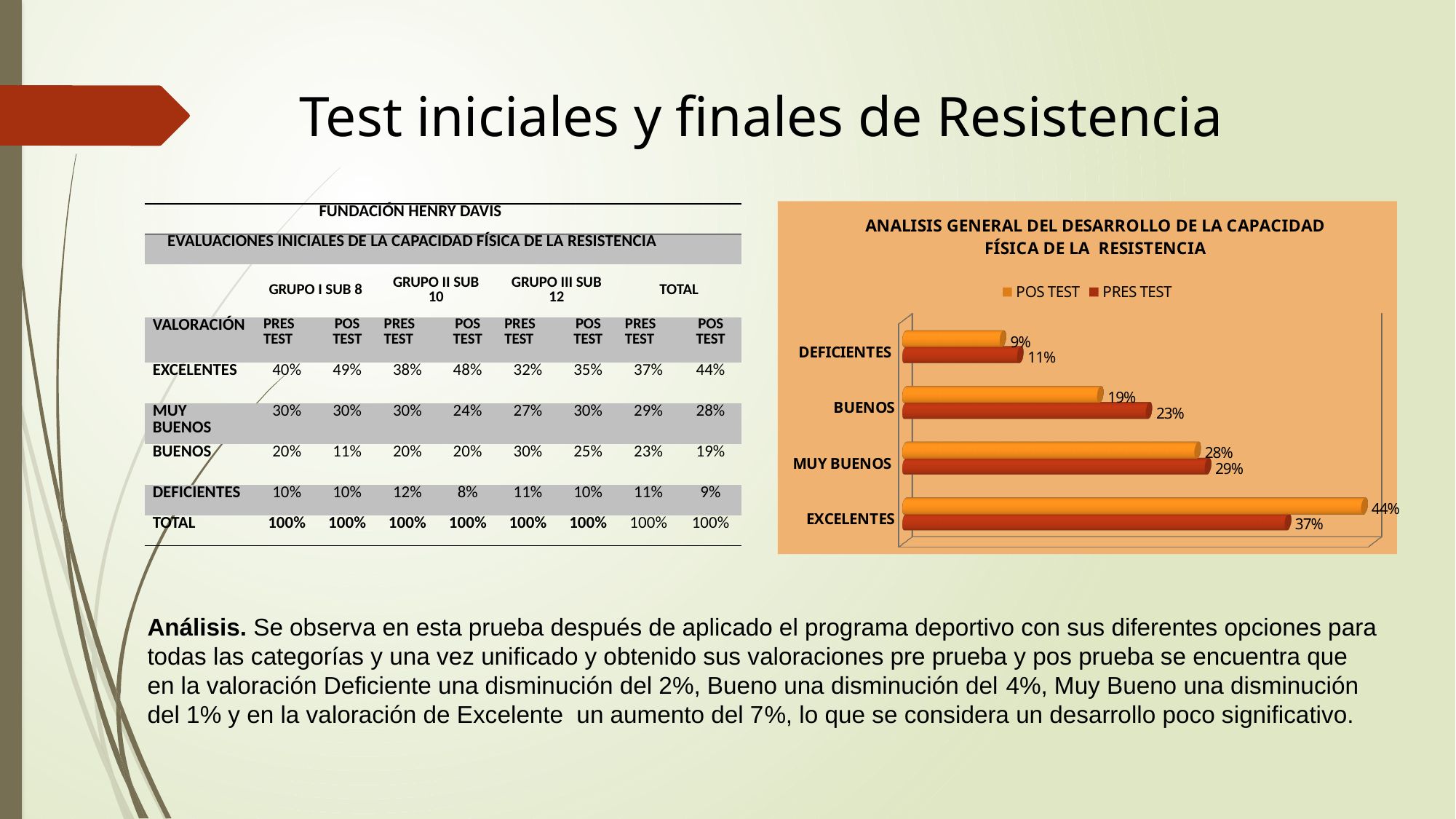
What is the POS TEST value for EXCELENTES in the chart? 44% Which category has the lowest PRES TEST value in the chart? DEFICIENTES For MUY BUENOS, which is larger in the chart: the POS TEST value or the PRES TEST value? PRES TEST What is the PRES TEST value for BUENOS in the chart? 23% What is the PRES TEST value for DEFICIENTES in the chart? 11% What is the difference between the POS TEST and PRES TEST values for EXCELENTES in the chart? 7% Which category has the highest POS TEST value in the chart? EXCELENTES What is the difference between the PRES TEST and POS TEST values for BUENOS in the chart? 4% How many categories are shown in the chart? 4 How many series does the chart legend list? 2 What is the title of the chart? ANALISIS GENERAL DEL DESARROLLO DE LA CAPACIDAD FÍSICA DE LA RESISTENCIA What kind of chart is shown on the slide? Bar chart